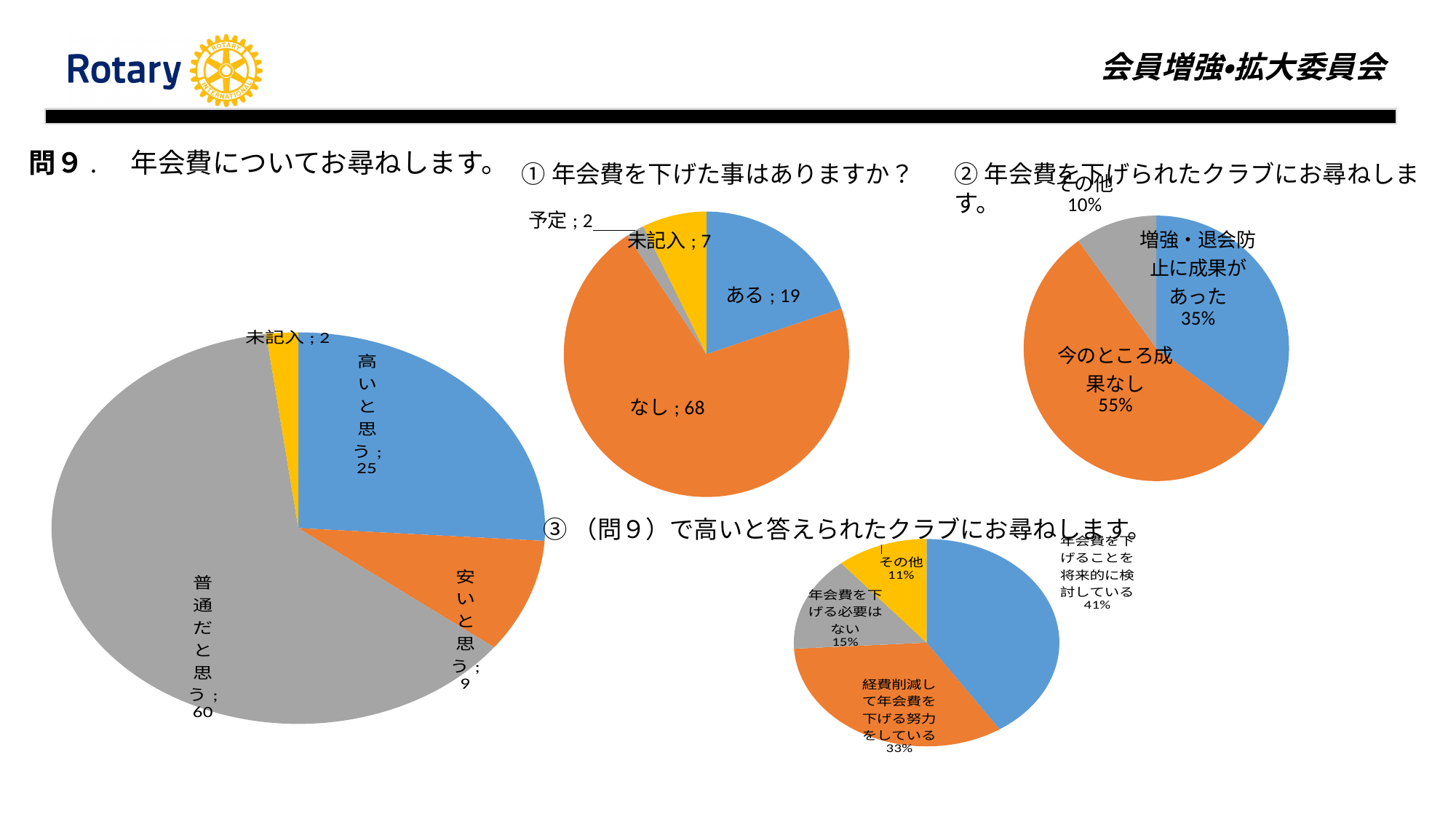
In the large pie chart on the left of the slide, which category has the smallest value? 未記入 In the pie chart titled ② 年会費を下げられたクラブにお尋ねします, what share does 今のところ成果なし have? 55% In the pie chart titled ③ （問９）で高いと答えられたクラブにお尋ねします, which category has the largest share? 年会費を下げることを将来的に検討している In the pie chart titled ① 年会費を下げた事はありますか？, what is the value for なし? 68 In the large pie chart on the left of the slide (問９ 年会費について), what is the value for 普通だと思う? 60 In the pie chart titled ② 年会費を下げられたクラブにお尋ねします, which category has the smallest share? その他 In the pie chart titled ① 年会費を下げた事はありますか？, which is larger, ある or 未記入? ある In the large pie chart on the left of the slide, what is the difference between 高いと思う and 安いと思う? 16 What type of chart is used for the chart titled ① 年会費を下げた事はありますか？? Pie chart How many slices does the large pie chart on the left of the slide have? 4 In the pie chart titled ① 年会費を下げた事はありますか？, which category has the largest value? なし In the pie chart titled ③ （問９）で高いと答えられたクラブにお尋ねします, what share does 年会費を下げる必要はない have? 15%